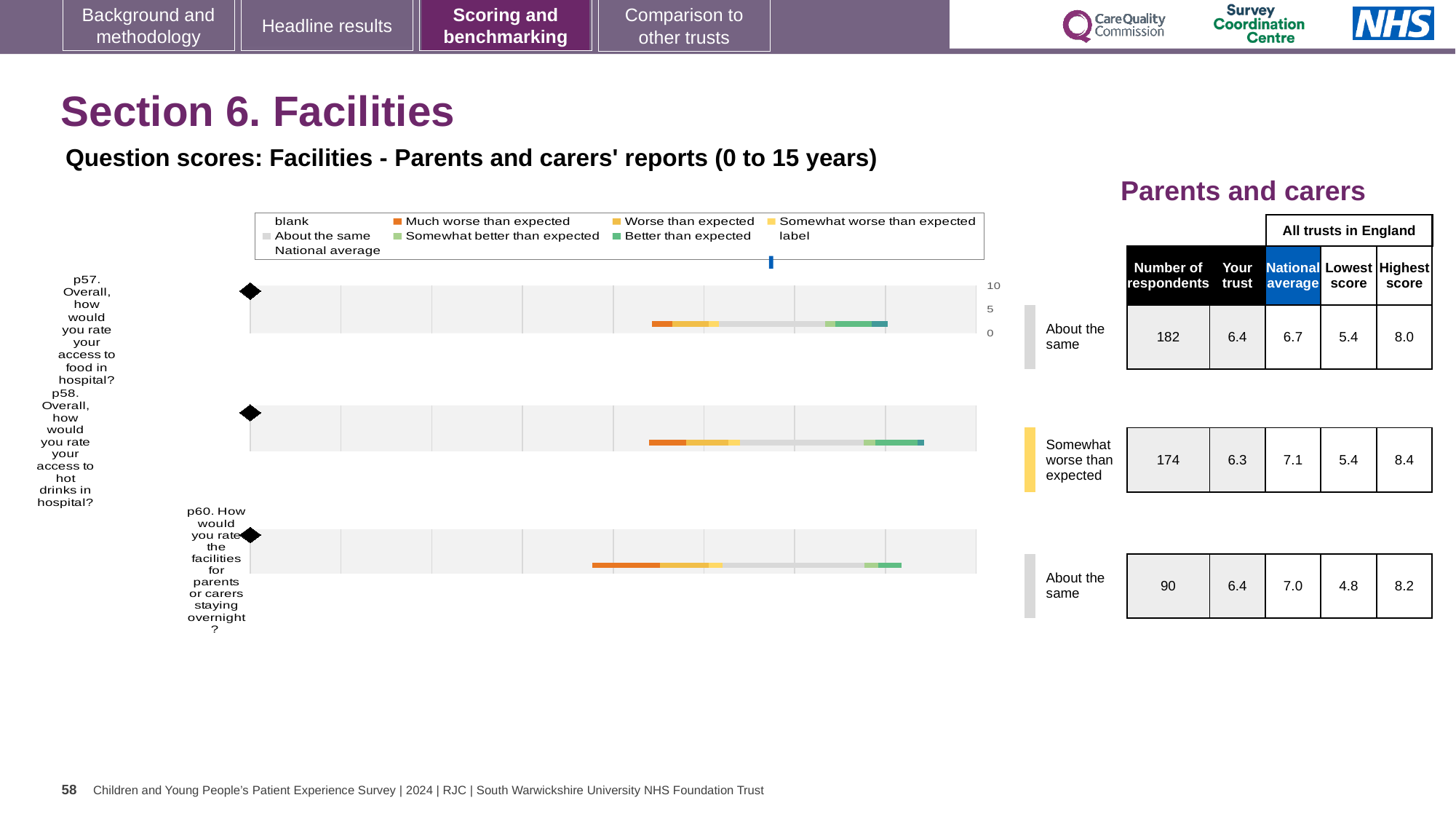
What is the national average score for p58 (access to hot drinks in hospital)? 7.1 What is the title shown above the table of scores on the right of the slide? Parents and carers What kind of chart is used to show the question scores for p57, p58 and p60? bar chart Which question has the highest 'Highest score' among all trusts in England? p58 How many respondents answered p60 (facilities for parents or carers staying overnight)? 90 For p58, how much higher is the national average than the trust's score? 0.8 Which has the higher 'Your trust' score, p57 or p58? p57 How many questions are plotted in the Facilities chart for parents and carers? 3 Which question has the lowest 'Lowest score' among all trusts in England? p60 What benchmark category is the trust's score for p58 placed in? Somewhat worse than expected What is the 'Your trust' score for p57 (access to food in hospital)? 6.4